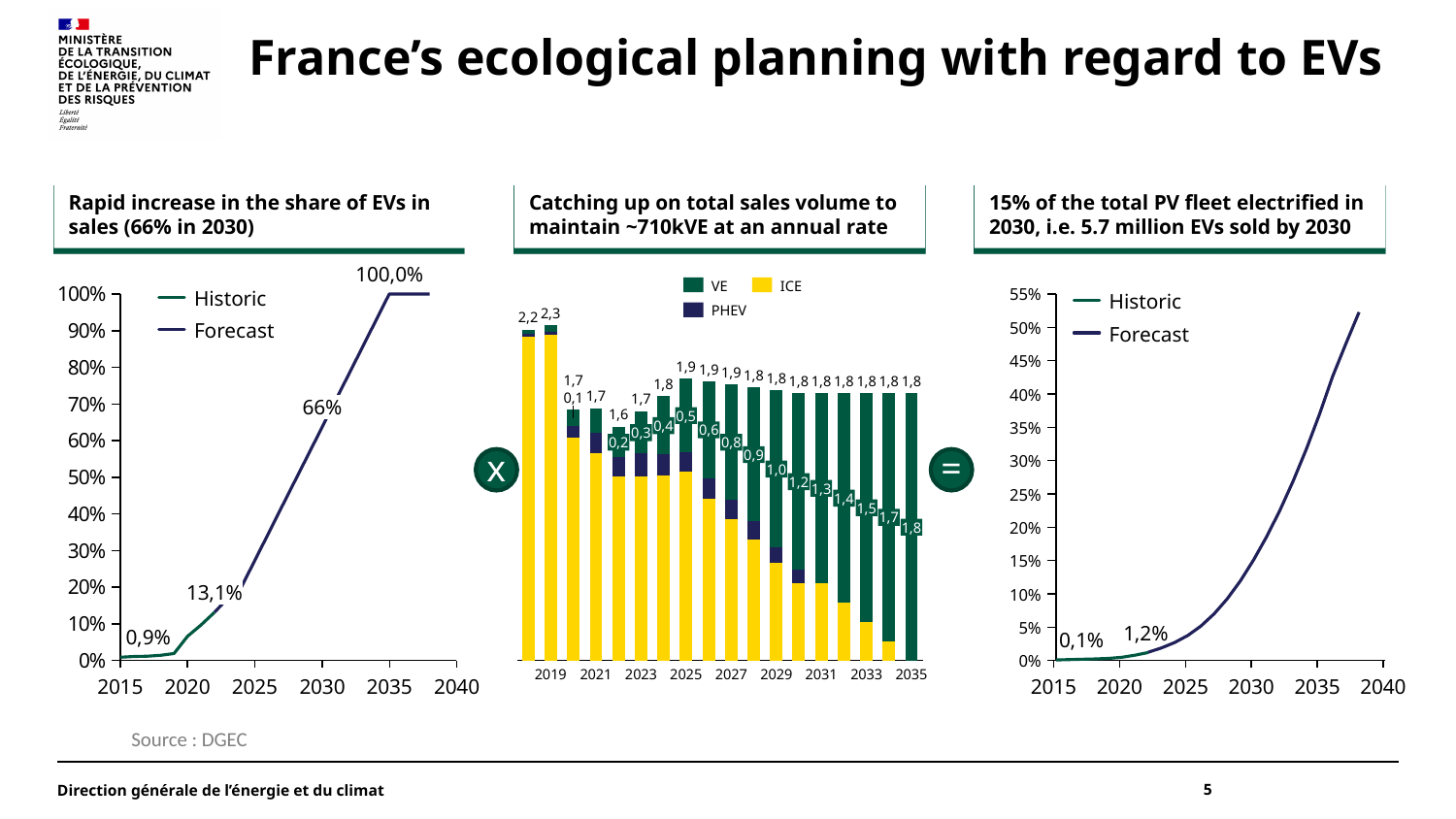
In the middle chart, 'Catching up on total sales volume', what is the total of the stacked bar for 2019? 2,2 What type of chart is the middle chart, 'Catching up on total sales volume'? bar chart In the right chart, '15% of the total PV fleet electrified in 2030', is the value for 2035 greater or less than 40%? less In the middle chart, 'Catching up on total sales volume', which year has the highest stacked bar total? 2020 In the middle chart, 'Catching up on total sales volume', what is the VE value labelled for 2035? 1,8 In the left chart, 'Rapid increase in the share of EVs in sales', what value is labelled at 2015? 0,9% How many series does the legend of the left chart, 'Rapid increase in the share of EVs in sales', list? 2 How many series does the legend of the middle chart, 'Catching up on total sales volume', list? 3 What type of chart is the left chart, 'Rapid increase in the share of EVs in sales'? line chart In the right chart, '15% of the total PV fleet electrified in 2030', what value is labelled at 2015? 0,1% In the left chart, 'Rapid increase in the share of EVs in sales', do the values rise or fall from 2015 to 2035? rise In the left chart, 'Rapid increase in the share of EVs in sales', what value is labelled for 2030? 66%